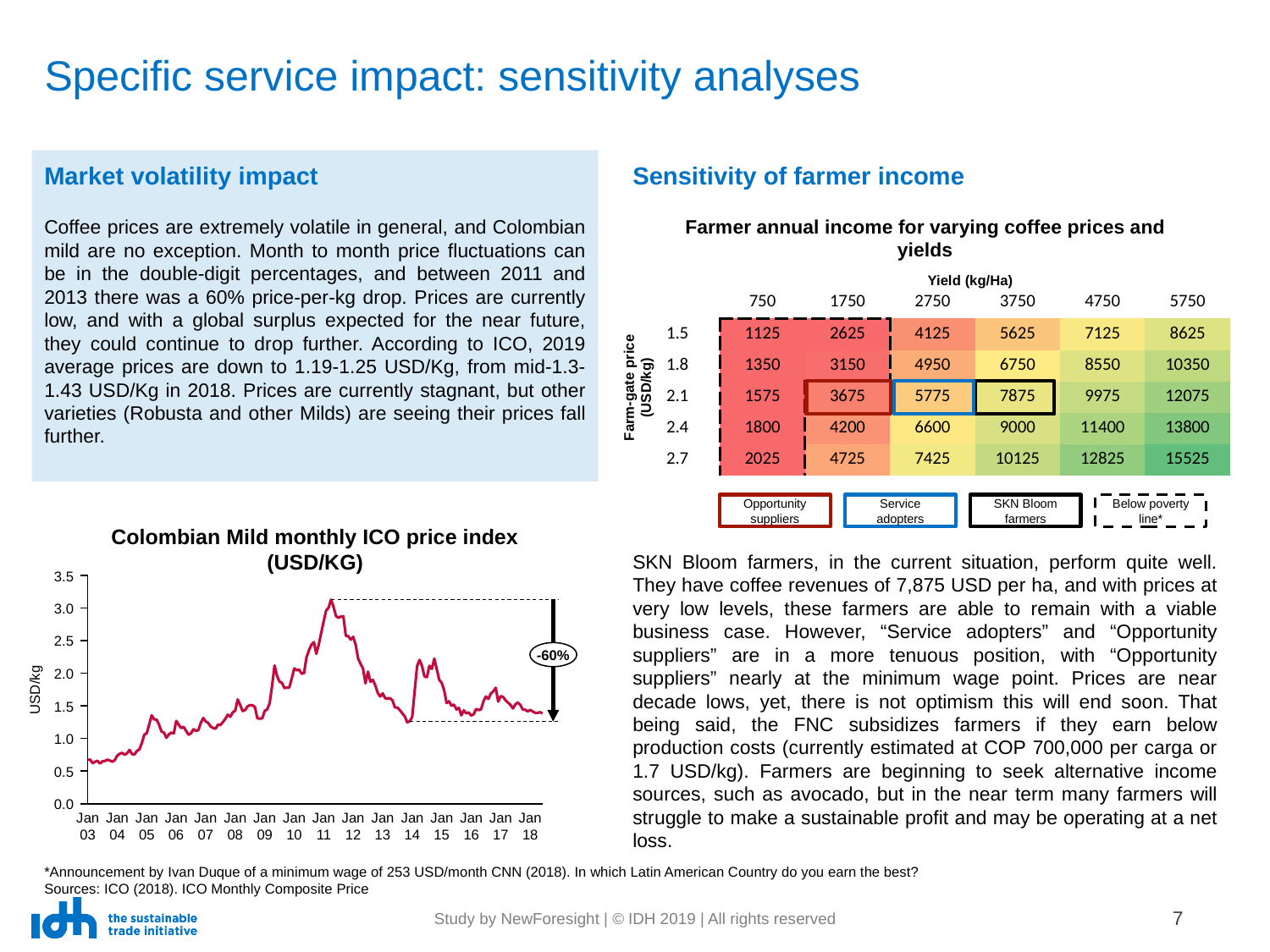
In the 'Farmer annual income for varying coffee prices and yields' table, what is the highest income value shown? 15525 In the 'Colombian Mild monthly ICO price index' chart, is the peak value around Jan 11 greater or less than 2.5? greater In the 'Colombian Mild monthly ICO price index' chart, how many January tick labels are shown on the x axis? 16 In the 'Farmer annual income for varying coffee prices and yields' table, what is the difference between the SKN Bloom farmers value (7875) and the Service adopters value (5775)? 2100 What kind of chart is the 'Colombian Mild monthly ICO price index (USD/KG)' chart? line chart In the 'Colombian Mild monthly ICO price index' chart, what percentage drop is annotated next to the arrow? -60% In the 'Colombian Mild monthly ICO price index' chart, does the price rise or fall between Jan 03 and Jan 11? rise In the 'Colombian Mild monthly ICO price index' chart, does the price rise or fall between Jan 11 and Jan 13? fall In the 'Colombian Mild monthly ICO price index' chart, is the value at Jan 18 greater or less than 2.0? less In the 'Farmer annual income for varying coffee prices and yields' table, what is the income at a farm-gate price of 2.1 USD/kg and a yield of 3750 kg/Ha? 7875 In the 'Colombian Mild monthly ICO price index' chart, what is the label on the y axis? USD/kg In the 'Colombian Mild monthly ICO price index' chart, is the value at Jan 03 greater or less than 1.0? less